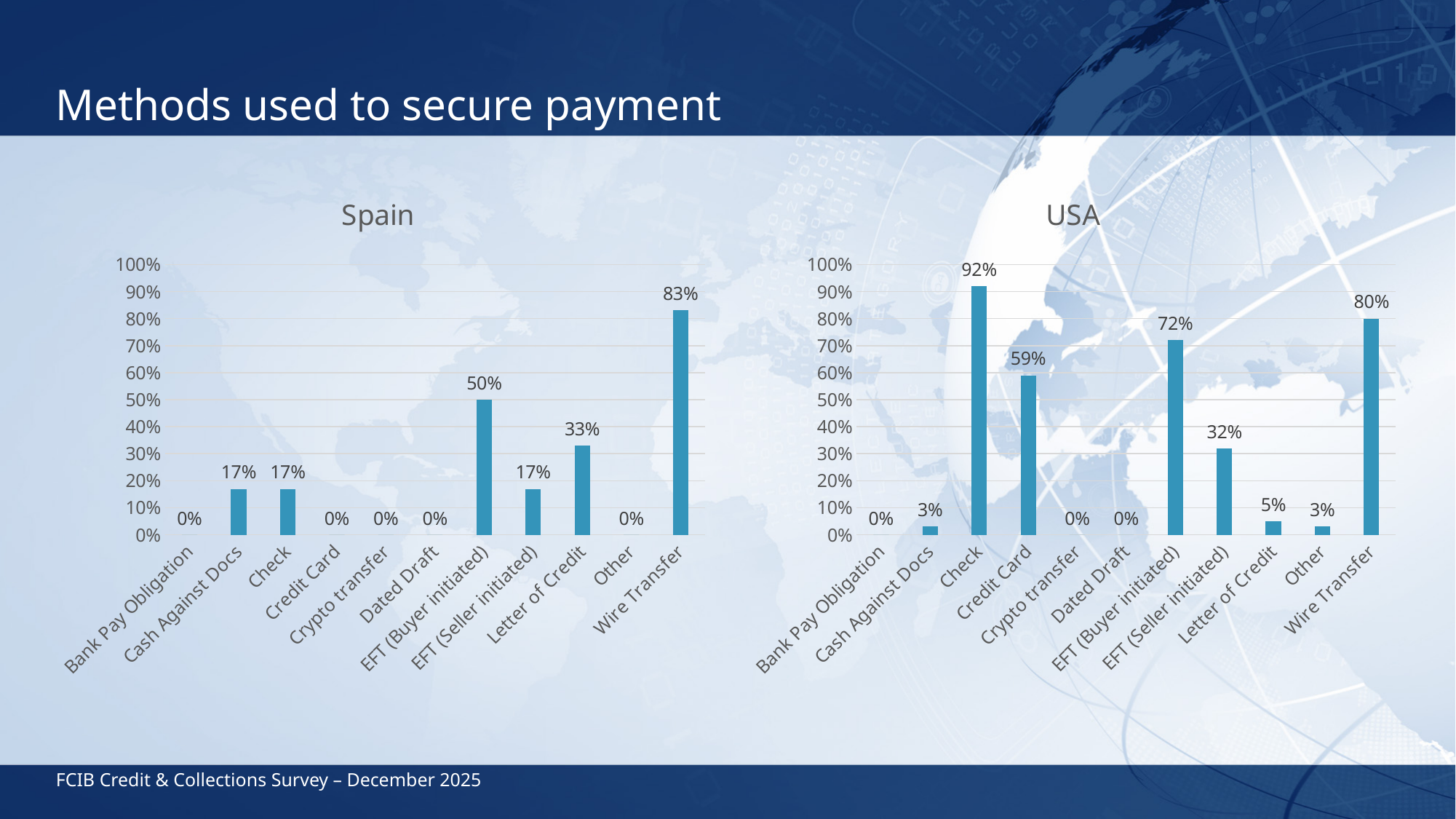
In the USA chart, which is larger, Credit Card or EFT (Buyer initiated)? EFT (Buyer initiated) In the Spain chart, what is the value for EFT (Buyer initiated)? 50% In the Spain chart, which method has the highest value? Wire Transfer What kind of chart is the USA chart? Bar chart In the USA chart, what is the value for Check? 92% In the USA chart, which method has the highest value? Check In the USA chart, what is the value for Letter of Credit? 5% In the USA chart, what is the difference between Check and Wire Transfer? 12% How many payment method categories are shown on the x axis of the Spain chart? 11 In the Spain chart, how many methods have a value of 0%? 5 In the Spain chart, what is the difference between Wire Transfer and Letter of Credit? 50% In the Spain chart, what is the value for Wire Transfer? 83%